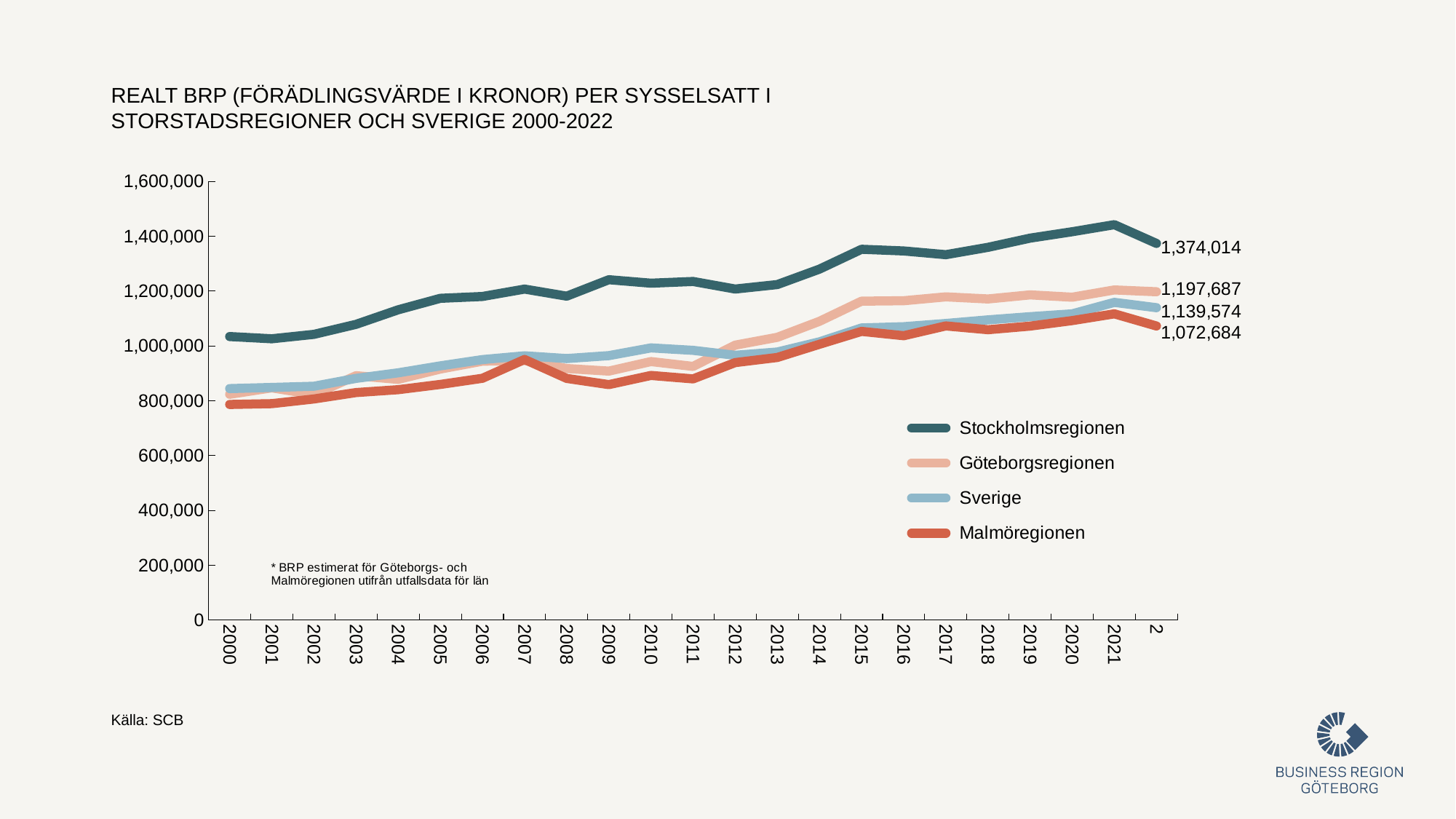
Which series has the highest value at the final data point? Stockholmsregionen What is the labelled value for Malmöregionen at the final data point (2022)? 1,072,684 What is the difference between the labelled 2022 values for Göteborgsregionen and Sverige? 58,113 What kind of chart is shown on the slide? Line chart What is the labelled value for Sverige at the final data point (2022)? 1,139,574 How many series does the legend list? 4 What is the labelled value for Göteborgsregionen at the final data point (2022)? 1,197,687 At the final data point, which is larger: Göteborgsregionen or Sverige? Göteborgsregionen What is the labelled value for Stockholmsregionen at the final data point (2022)? 1,374,014 Is the value for Stockholmsregionen in 2021 greater or less than 1,400,000? greater Which series has the lowest value at the final data point? Malmöregionen What is the difference between the labelled 2022 values for Stockholmsregionen and Malmöregionen? 301,330